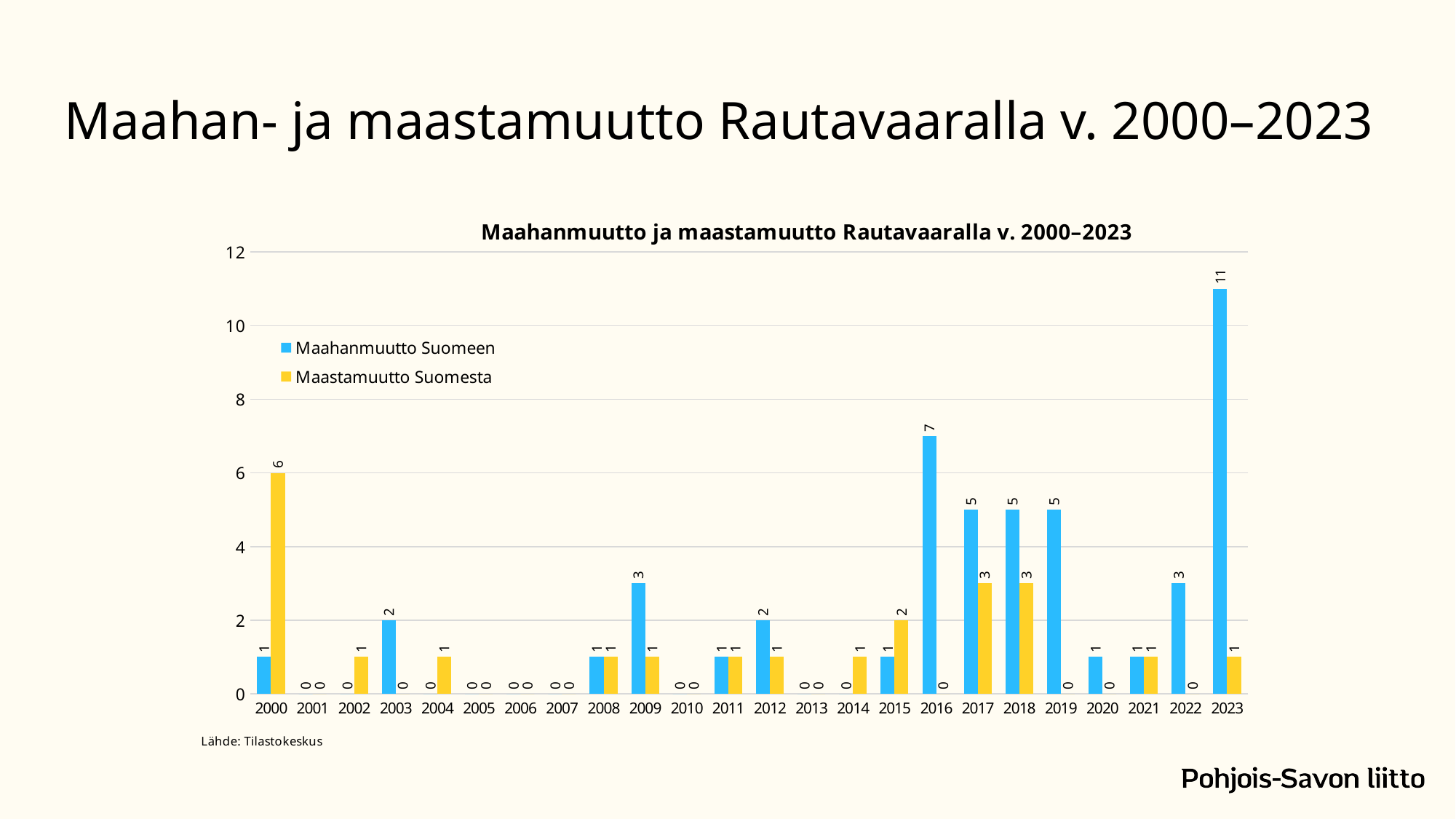
Is the value of Maahanmuutto Suomeen in 2023 greater or less than 10? greater In which year is Maahanmuutto Suomeen highest? 2023 What is the difference between Maahanmuutto Suomeen and Maastamuutto Suomesta in 2023? 10 What is the value of Maastamuutto Suomesta in 2017? 3 How many series does the legend list? 2 In which year is Maastamuutto Suomesta highest? 2000 What is the value of Maastamuutto Suomesta in 2000? 6 What is the value of Maahanmuutto Suomeen in 2016? 7 How many years are shown on the x axis? 24 Which is larger in 2015, Maahanmuutto Suomeen or Maastamuutto Suomesta? Maastamuutto Suomesta What is the value of Maahanmuutto Suomeen in 2023? 11 What kind of chart is shown on the slide? Bar chart